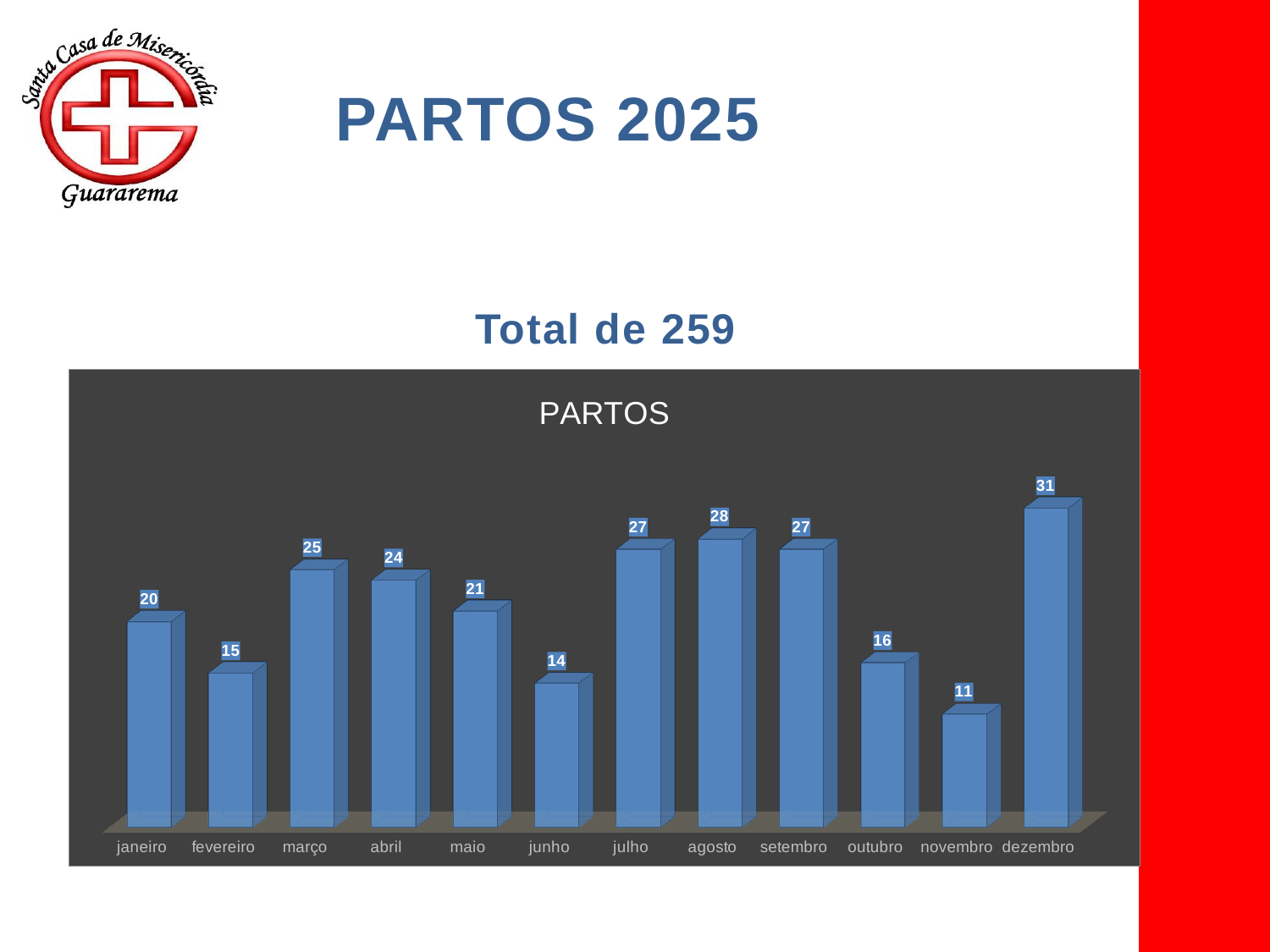
Which month has the highest value in the PARTOS chart? dezembro What is the value for junho in the PARTOS chart? 14 What total is stated above the PARTOS chart? Total de 259 What is the difference between the values for julho and fevereiro in the PARTOS chart? 12 What is the value for agosto in the PARTOS chart? 28 Which is larger in the PARTOS chart, the value for janeiro or the value for outubro? janeiro What is the title of the chart on the slide? PARTOS What is the value for março in the PARTOS chart? 25 Which month has the lowest value in the PARTOS chart? novembro What is the difference between the values for dezembro and novembro in the PARTOS chart? 20 What kind of chart is the PARTOS chart? bar chart How many months are shown in the PARTOS chart? 12